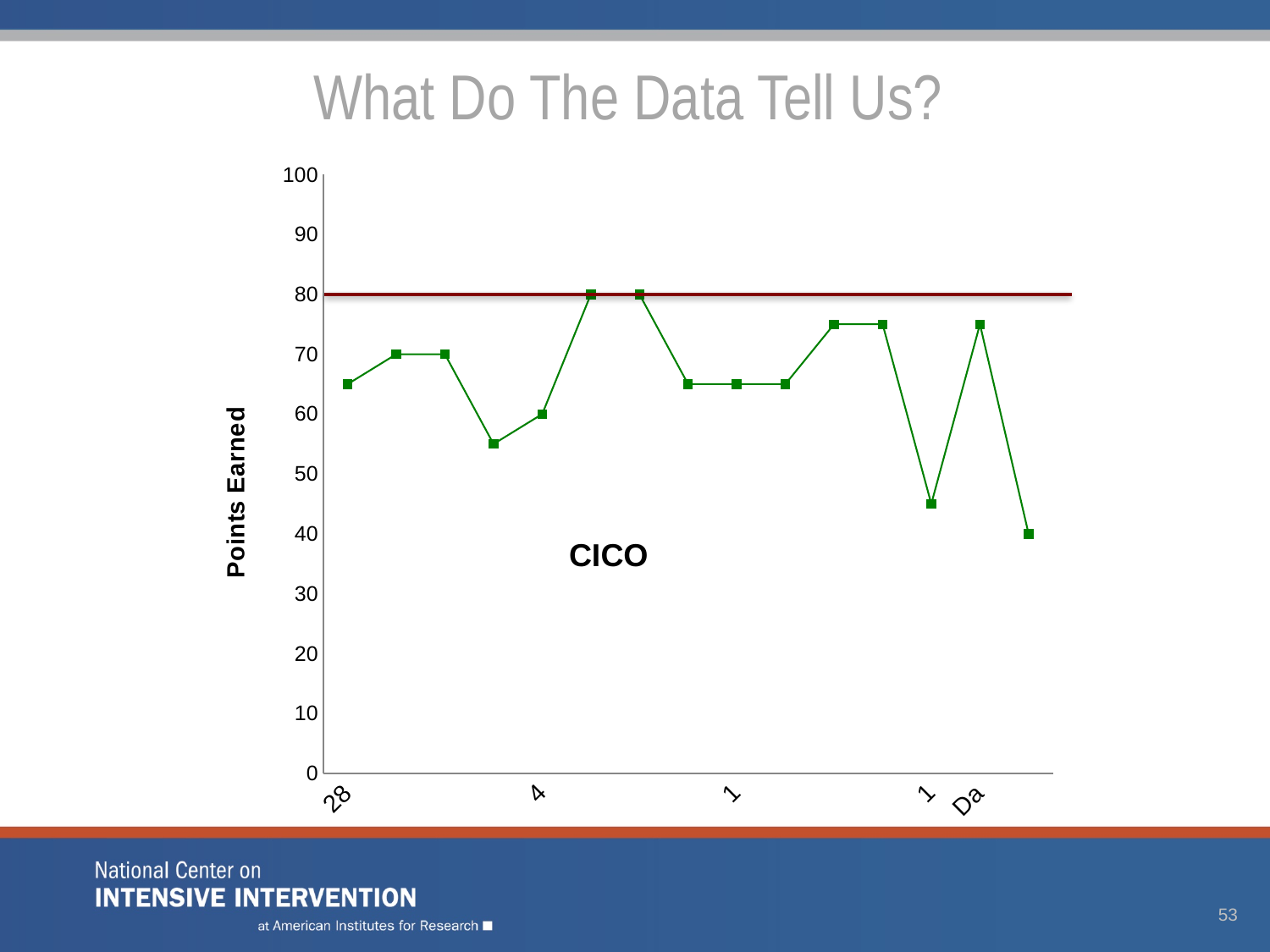
What is the value of the last data point on the green line? 40 What is the lowest value on the green line? 40 What is the highest value reached by the green line? 80 What text label appears inside the plot area below the line? CICO Overall, do the values rise or fall from the first point to the last point? fall Is the value of the first data point greater or less than 60? greater At what value on the Points Earned axis is the red horizontal line drawn? 80 Is the value of the last data point greater or less than 50? less Which is larger, the first data point or the last data point on the green line? the first data point What is the title of the vertical axis? Points Earned How many data points are plotted on the green line? 15 What kind of chart is shown on the slide? line chart